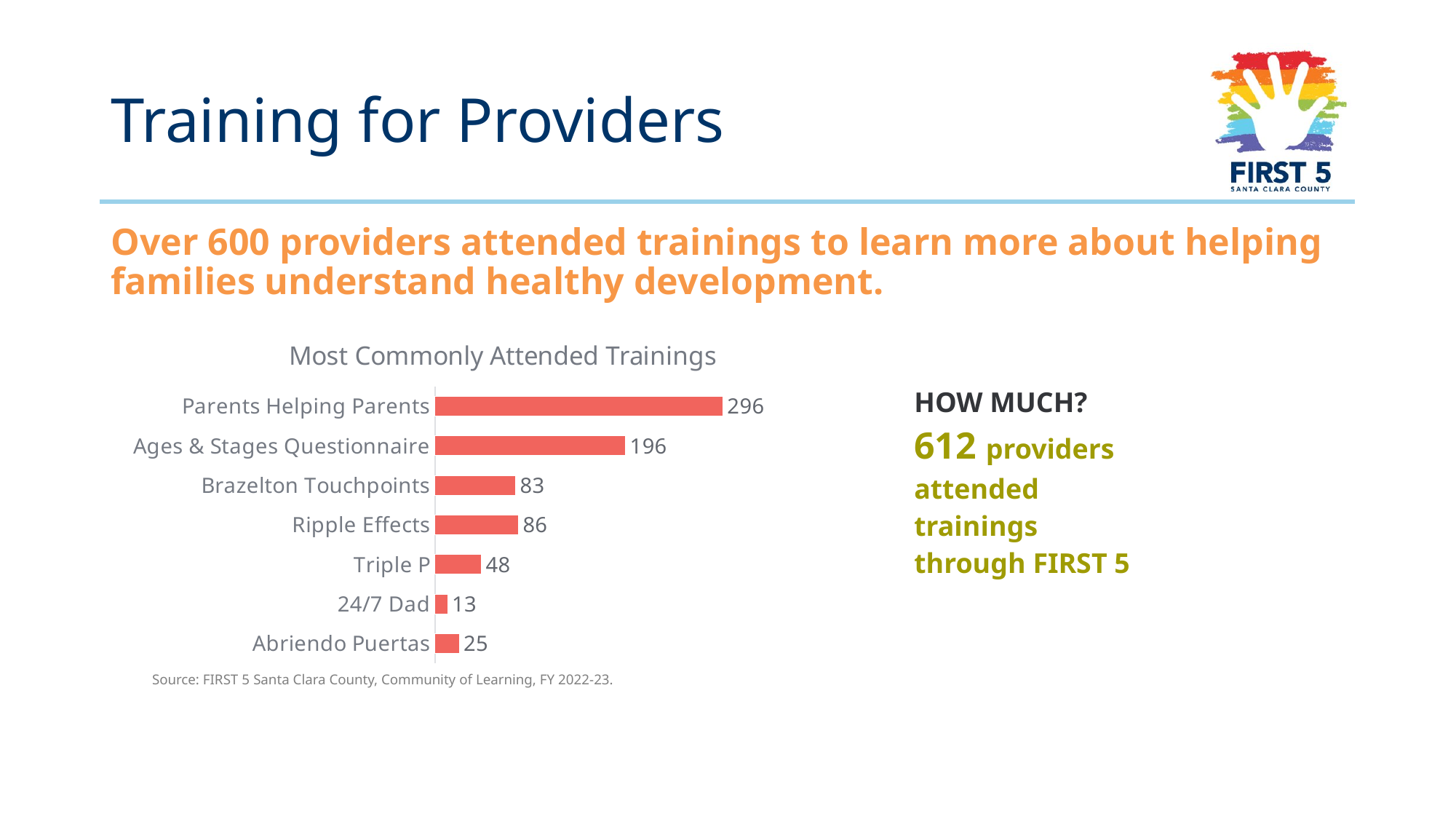
What kind of chart is shown? Bar chart What is the value for Ages & Stages Questionnaire? 196 What is the value for Abriendo Puertas? 25 How many trainings are shown in the chart? 7 Which training has the lowest value? 24/7 Dad Which training has the highest value? Parents Helping Parents What is the value for Triple P? 48 What is the difference between Parents Helping Parents and Ages & Stages Questionnaire? 100 What is the difference between Ripple Effects and Brazelton Touchpoints? 3 Which is larger, Triple P or Abriendo Puertas? Triple P What is the title of the chart? Most Commonly Attended Trainings What is the value for Parents Helping Parents? 296